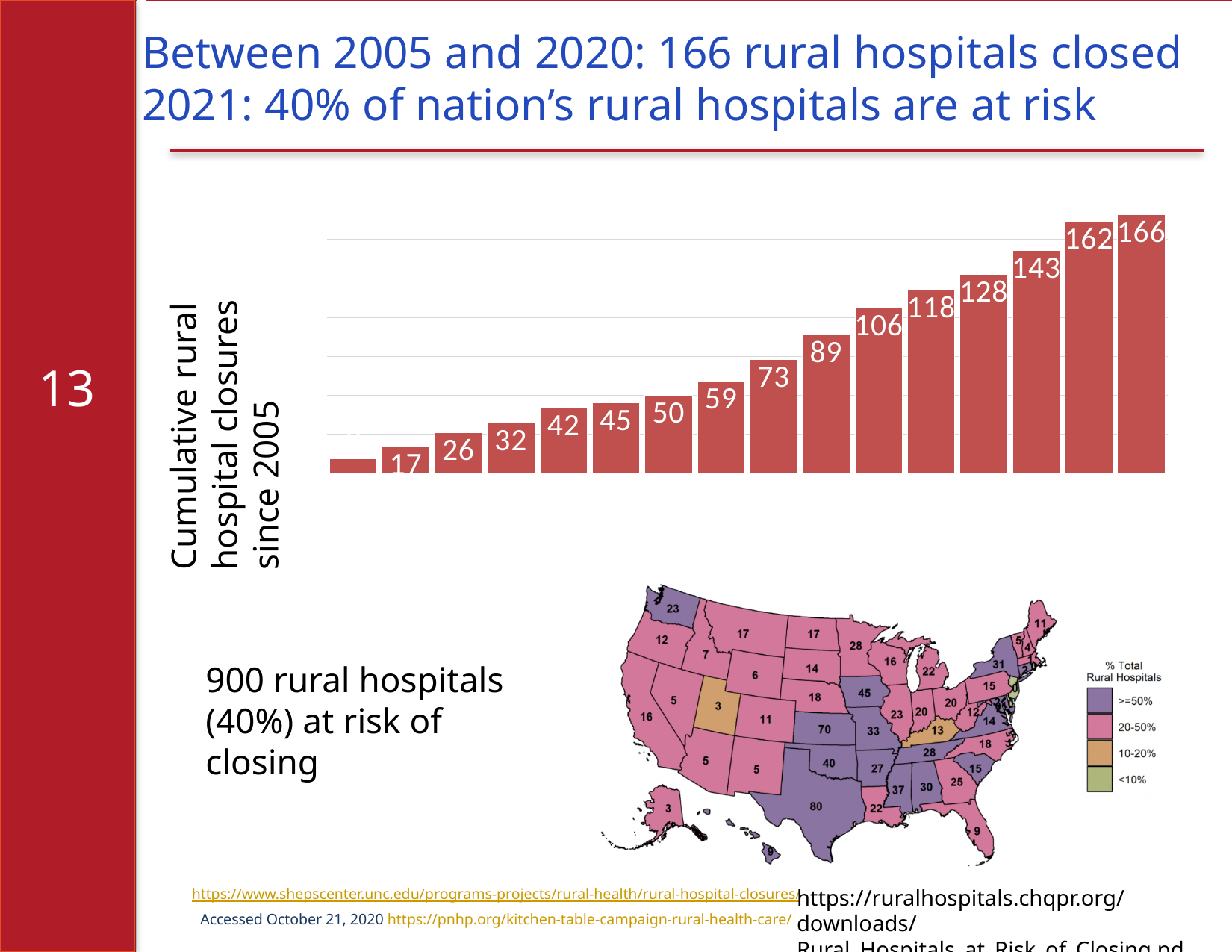
What is the difference between the bars labelled 143 and 128? 15 What is the value of the bar immediately to the left of the bar labelled 106? 89 Do the bar values rise or fall from left to right across the chart? rise What colour are the bars in the chart? red What kind of chart is shown on the slide? bar chart What is the value of the second bar from the left in the chart? 17 What is the difference between the last two bars, labelled 166 and 162? 4 How many bars are plotted in the chart? 16 What is the value of the rightmost bar in the chart? 166 What is the vertical axis title of the bar chart? Cumulative rural hospital closures since 2005 What is the highest value labelled on the bar chart? 166 What is the difference between the bars labelled 118 and 106? 12